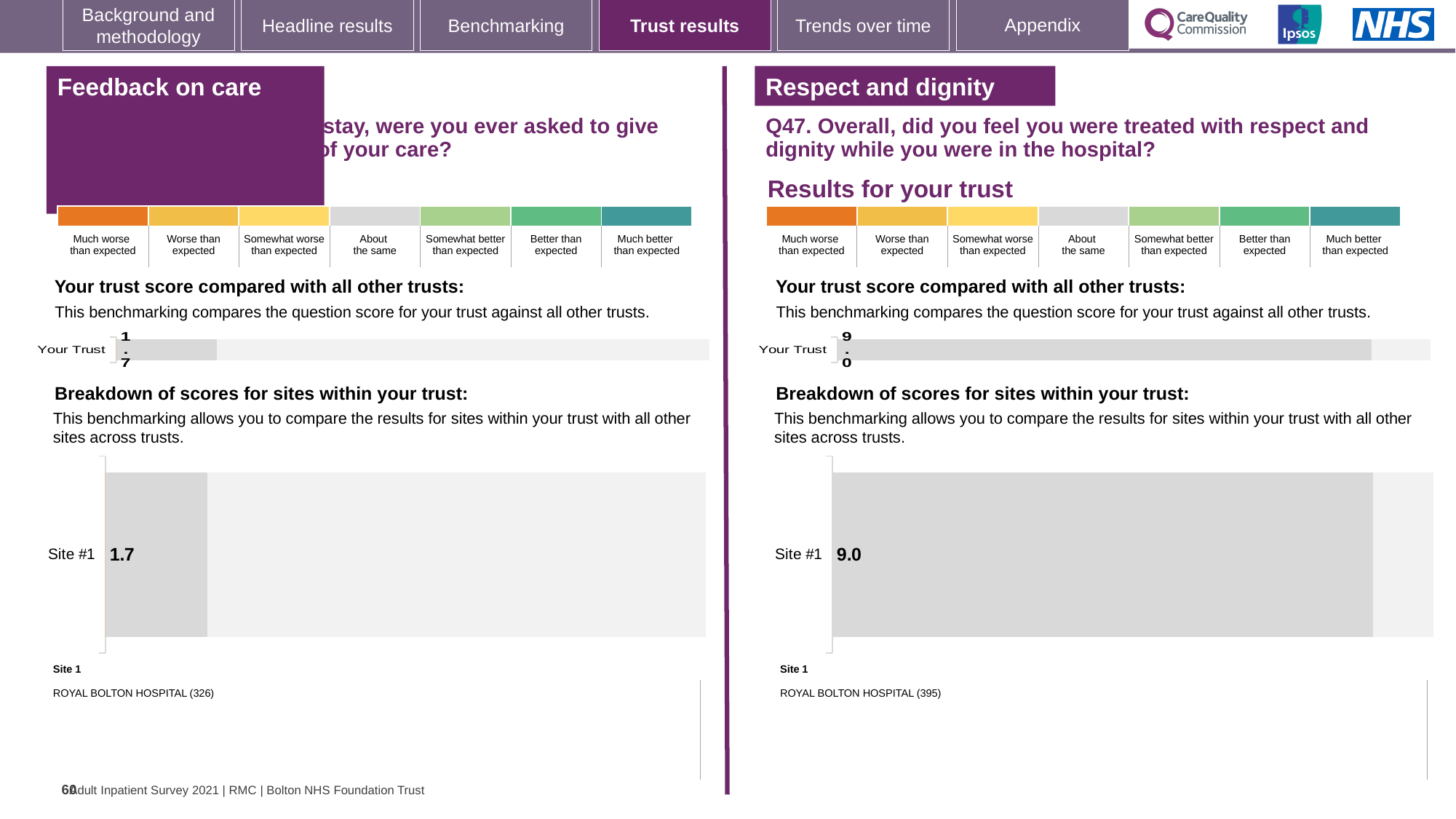
Which is larger: the Site #1 score in the left-hand 'Feedback on care' breakdown chart or the Site #1 score in the right-hand 'Respect and dignity' breakdown chart? Respect and dignity (9.0) In the right-hand 'Breakdown of scores for sites within your trust' chart, what is the score for Site #1? 9.0 In the left-hand 'Breakdown of scores for sites within your trust' chart, what is the score for Site #1? 1.7 How many sites are plotted in the right-hand 'Breakdown of scores for sites within your trust' chart? 1 On the left-hand 'Feedback on care' section, what is the 'Your Trust' score shown in the trust benchmarking chart? 1.7 What is the difference between the Site #1 score in the right-hand 'Respect and dignity' breakdown chart and the Site #1 score in the left-hand 'Feedback on care' breakdown chart? 7.3 What type of chart is used for the site breakdown on the left-hand 'Feedback on care' section? Bar chart What type of chart is used for the 'Your Trust' benchmarking on the right-hand 'Respect and dignity' section? Bar chart How many sites are plotted in the left-hand 'Breakdown of scores for sites within your trust' chart? 1 Which hospital is listed as Site 1 beneath the right-hand 'Respect and dignity' breakdown chart? ROYAL BOLTON HOSPITAL (395) Which hospital is listed as Site 1 beneath the left-hand 'Feedback on care' breakdown chart? ROYAL BOLTON HOSPITAL (326) On the right-hand 'Respect and dignity' section, what is the 'Your Trust' score shown in the trust benchmarking chart? 9.0